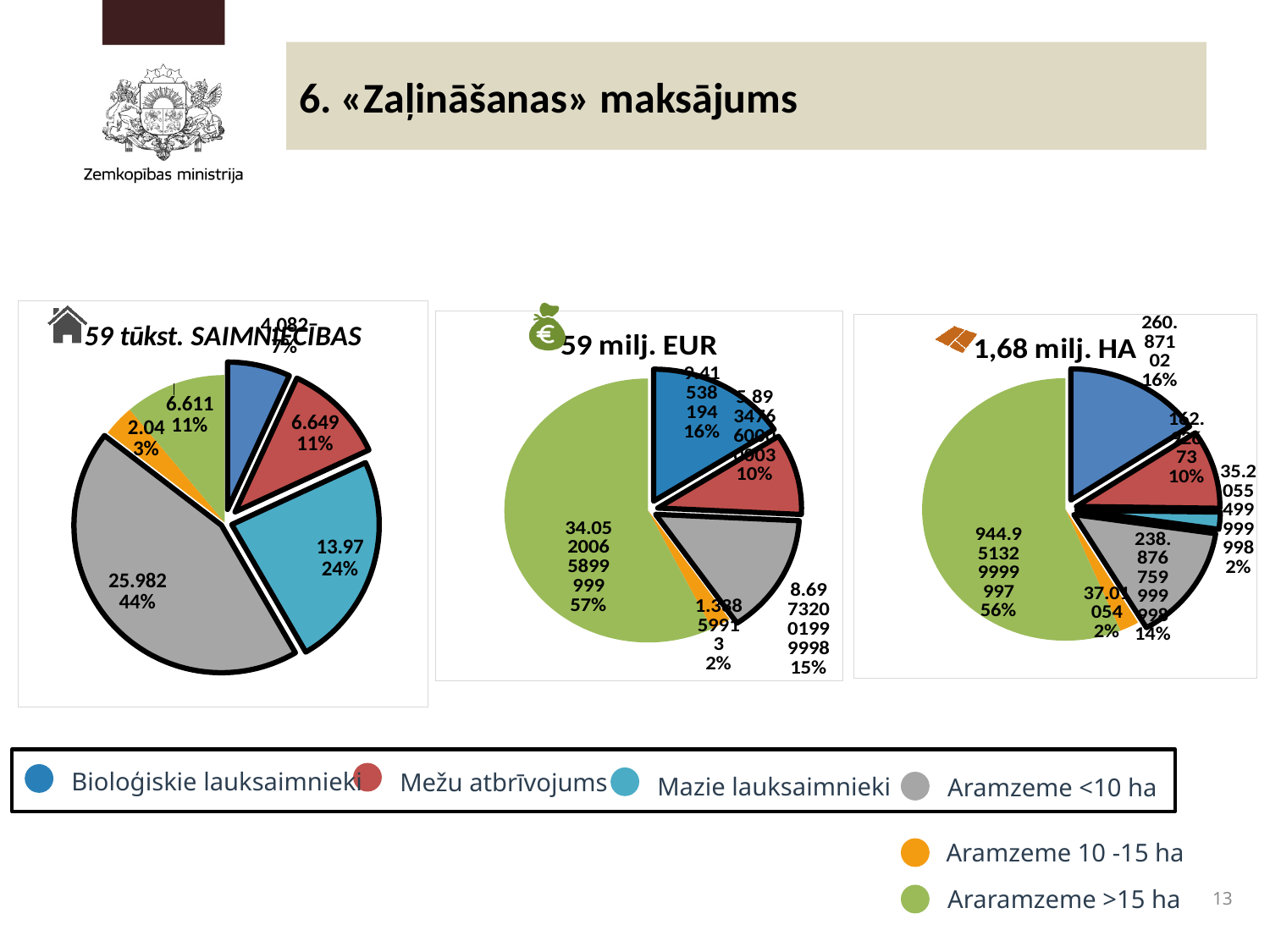
In the '59 milj. EUR' pie chart, what percentage share does Araramzeme >15 ha have? 57% In the '59 milj. EUR' pie chart, what percentage share does Aramzeme <10 ha have? 15% In the '59 milj. EUR' pie chart, which is larger: the share for Bioloģiskie lauksaimnieki or the share for Mežu atbrīvojums? Bioloģiskie lauksaimnieki In the '59 tūkst. SAIMNIECĪBAS' pie chart, what value is shown for Aramzeme <10 ha? 25.982 How many categories does the legend on the slide list? 6 In the '1,68 milj. HA' pie chart, what percentage share does Aramzeme <10 ha have? 14% In the '59 tūkst. SAIMNIECĪBAS' pie chart, what value is shown for Mežu atbrīvojums? 6.649 In the '59 tūkst. SAIMNIECĪBAS' pie chart, what is the difference between the values for Mazie lauksaimnieki and Mežu atbrīvojums? 7.321 In the '1,68 milj. HA' pie chart, which category has the largest slice? Araramzeme >15 ha In the '59 tūkst. SAIMNIECĪBAS' pie chart, which category has the smallest slice? Aramzeme 10 -15 ha In the '59 tūkst. SAIMNIECĪBAS' pie chart, which category has the largest slice? Aramzeme <10 ha